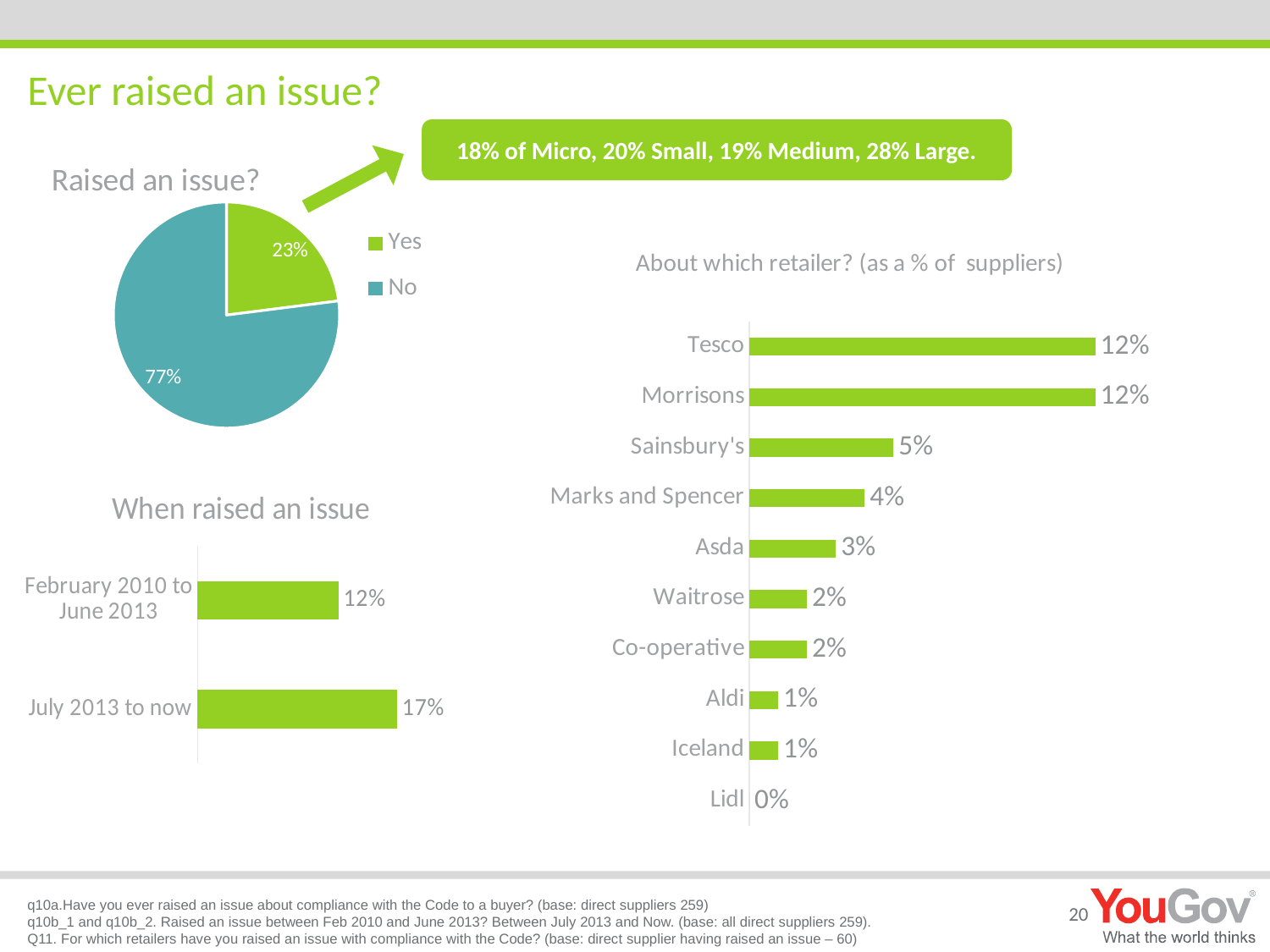
How many entries does the legend of the 'Raised an issue?' pie chart list? 2 In the 'Raised an issue?' pie chart, what percentage answered Yes? 23% In the 'When raised an issue' chart, what is the difference between July 2013 to now and February 2010 to June 2013? 5% What kind of chart is the 'Raised an issue?' chart? pie chart In the 'About which retailer?' chart, what is the value for Sainsbury's? 5% In the 'About which retailer?' chart, which retailer has the lowest value? Lidl In the 'About which retailer?' chart, what is the difference between Tesco and Asda? 9% In the 'When raised an issue' chart, what is the value for July 2013 to now? 17% In the 'About which retailer?' chart, how many retailers are listed? 10 In the 'Raised an issue?' pie chart, what percentage answered No? 77% In the 'When raised an issue' chart, which period has the higher value? July 2013 to now What kind of chart is the 'About which retailer?' chart? bar chart